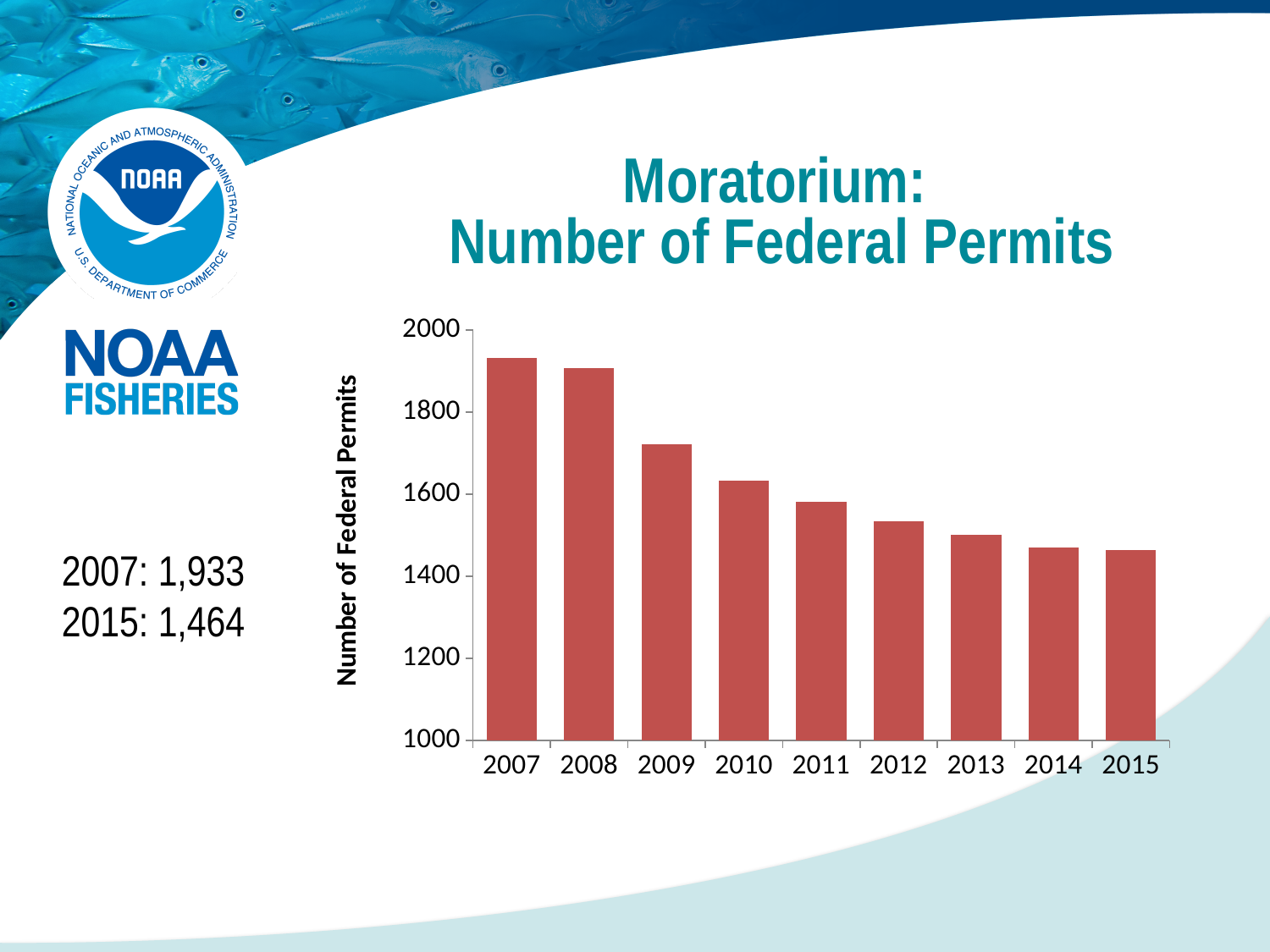
Is the value for 2009 greater or less than 1800? less What is the number of federal permits in 2007? 1,933 How many years are shown on the x axis of the chart? 9 What is the number of federal permits in 2015? 1,464 What is the label on the vertical axis of the chart? Number of Federal Permits Do the number of federal permits rise or fall from 2007 to 2015? fall By how much did the number of federal permits fall from 2007 to 2015? 469 What kind of chart is shown on the slide? bar chart Which year has the highest number of federal permits? 2007 Is the value for 2012 greater or less than 1600? less What is the title of the chart on the slide? Moratorium: Number of Federal Permits Which year has more federal permits, 2009 or 2012? 2009